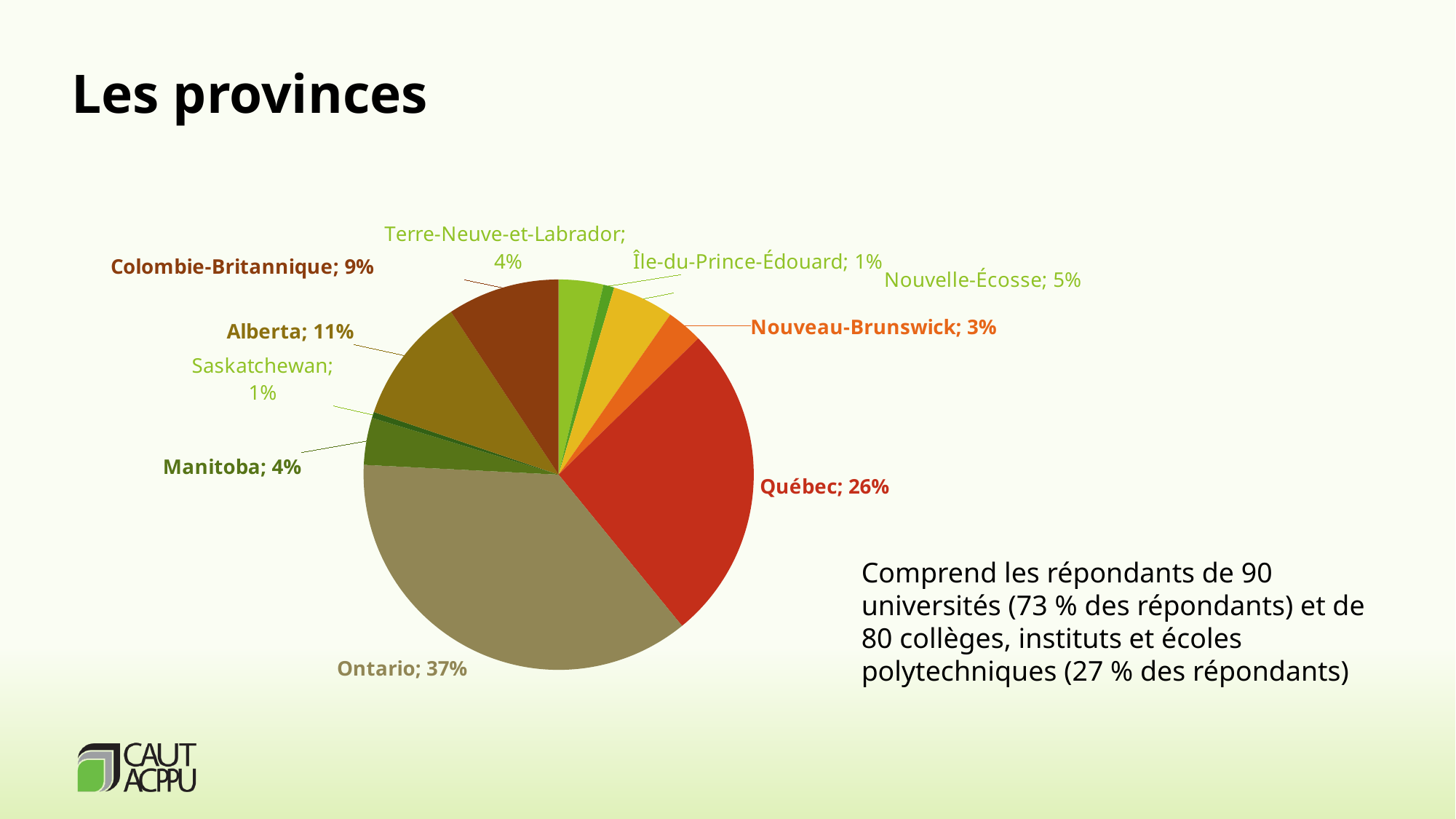
What is the difference between the shares of Alberta and Colombie-Britannique? 2% What is the value for Nouvelle-Écosse? 5% How many provinces are shown in the pie chart? 10 What kind of chart is shown on the slide? Pie chart What is the value shown for Québec? 26% What share of the pie does Ontario represent? 37% What is the difference between the shares of Ontario and Québec? 11% What is the title of the slide containing the chart? Les provinces Which province has the largest slice of the pie? Ontario What percentage is shown for Alberta? 11% Which has a larger share, Colombie-Britannique or Manitoba? Colombie-Britannique Which has a larger share, Nouvelle-Écosse or Nouveau-Brunswick? Nouvelle-Écosse